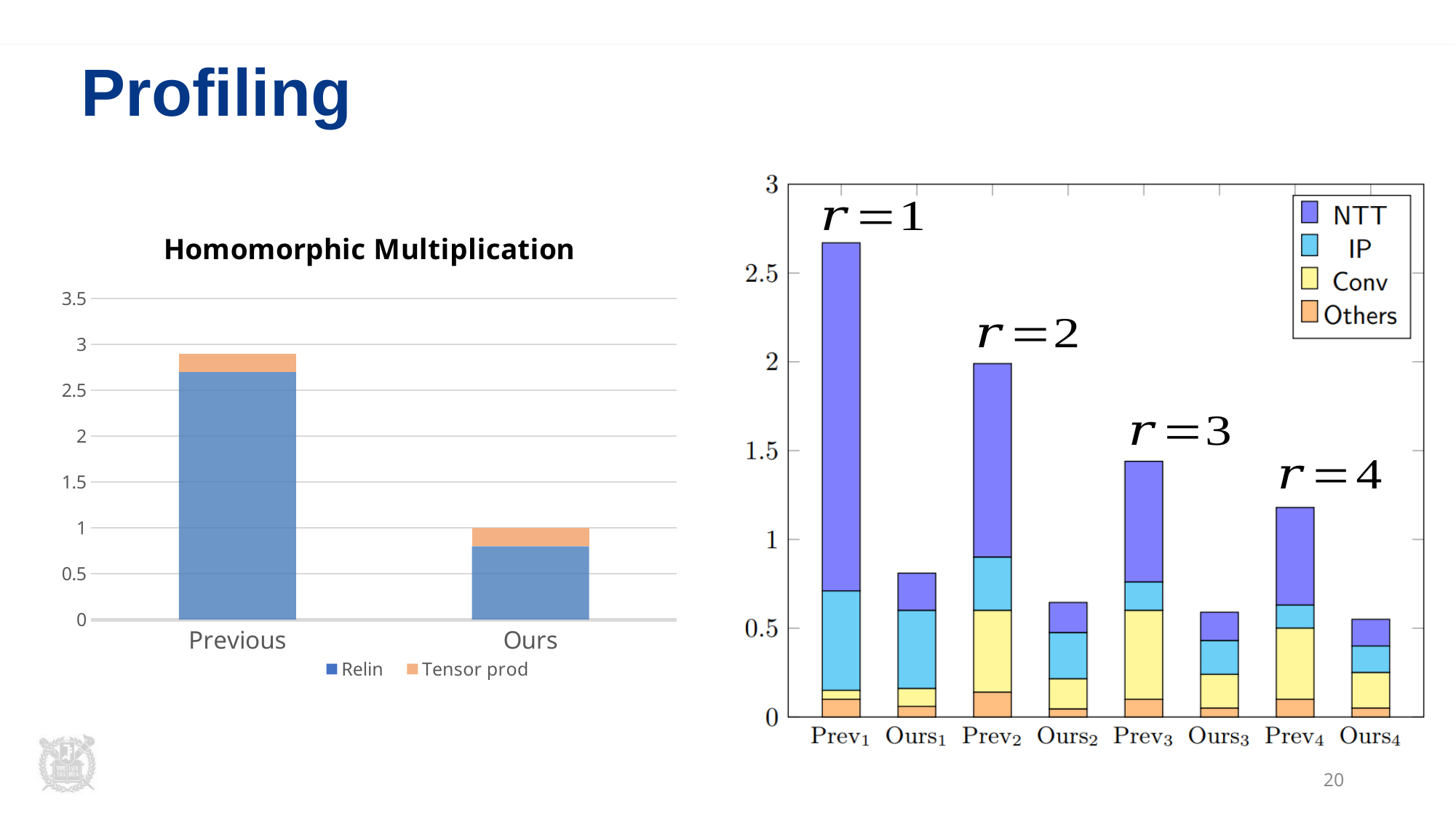
In the chart on the right, is the total for Prev1 greater or less than 2.5? greater In the 'Homomorphic Multiplication' chart, is the total for Ours greater or less than 1.5? less In the chart on the right, how many series does the legend list? 4 What type of chart is the 'Homomorphic Multiplication' chart on the left? stacked bar chart In the chart on the right, is the total for Ours1 greater or less than 1? less In the 'Homomorphic Multiplication' chart, which series is shown in orange? Tensor prod In the chart on the right, how many bars are plotted? 8 In the 'Homomorphic Multiplication' chart, how many series does the legend list? 2 In the chart on the right, which bar is the tallest? Prev1 In the chart on the right, which bar is taller, Prev3 or Prev4? Prev3 In the 'Homomorphic Multiplication' chart, which category has the taller bar, Previous or Ours? Previous